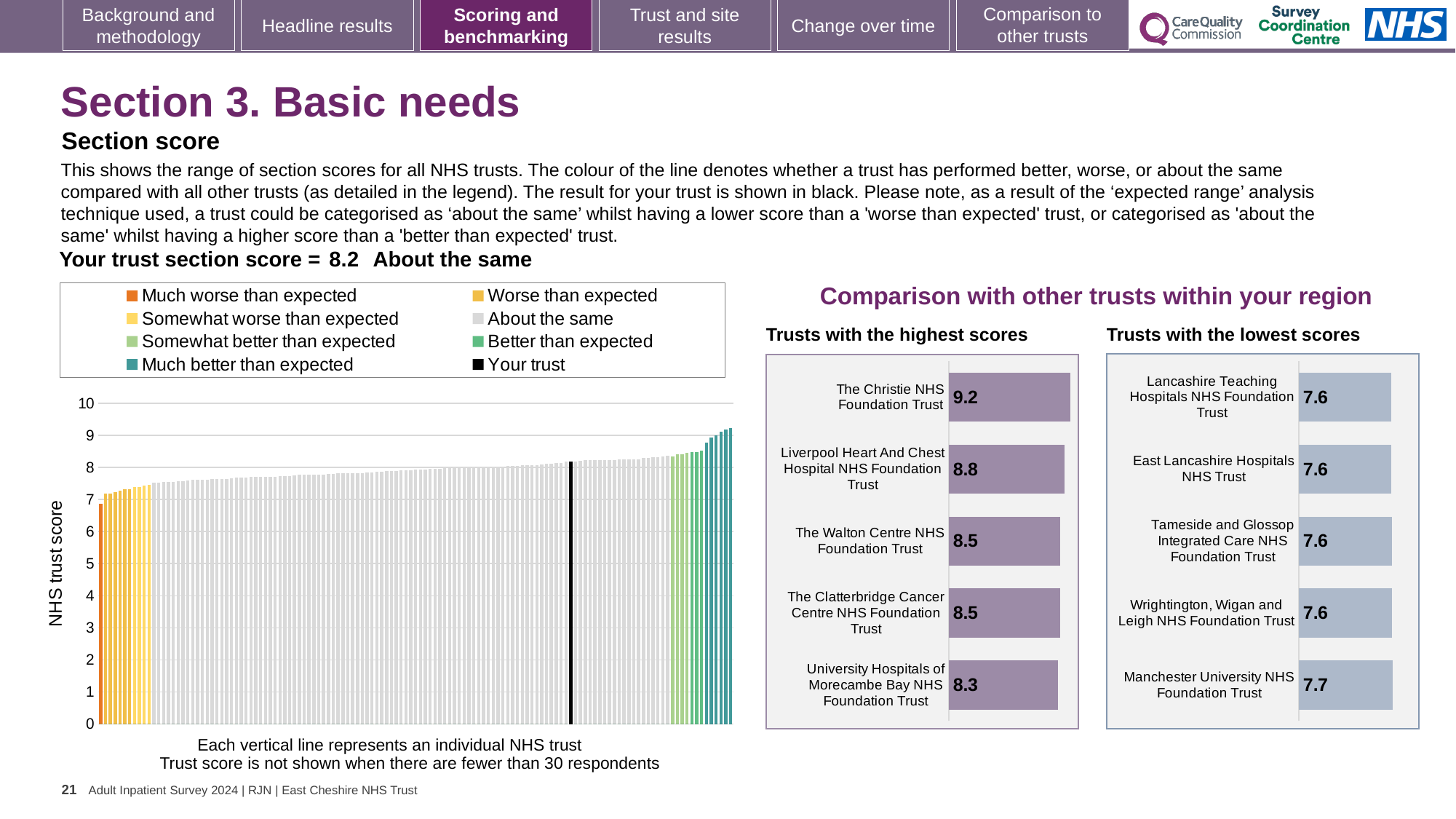
How many entries does the legend of the main NHS trust score chart list? 8 What is the label on the vertical axis of the main NHS trust score chart? NHS trust score On the 'Trusts with the lowest scores' chart, which trust has the highest score? Manchester University NHS Foundation Trust What kind of chart is the main chart showing NHS trust scores on the left of the slide? Bar chart How many trusts are shown on the 'Trusts with the lowest scores' chart? 5 On the 'Trusts with the highest scores' chart, what is the difference between the scores of The Christie NHS Foundation Trust and University Hospitals of Morecambe Bay NHS Foundation Trust? 0.9 On the 'Trusts with the lowest scores' chart, what is the score for Manchester University NHS Foundation Trust? 7.7 On the 'Trusts with the highest scores' chart, what is the score for The Christie NHS Foundation Trust? 9.2 On the main NHS trust score chart, do the bar values rise or fall from left to right? Rise On the 'Trusts with the highest scores' chart, which has the larger score: Liverpool Heart And Chest Hospital NHS Foundation Trust or The Walton Centre NHS Foundation Trust? Liverpool Heart And Chest Hospital NHS Foundation Trust On the 'Trusts with the highest scores' chart, what is the score for University Hospitals of Morecambe Bay NHS Foundation Trust? 8.3 On the 'Trusts with the highest scores' chart, which trust has the highest score? The Christie NHS Foundation Trust